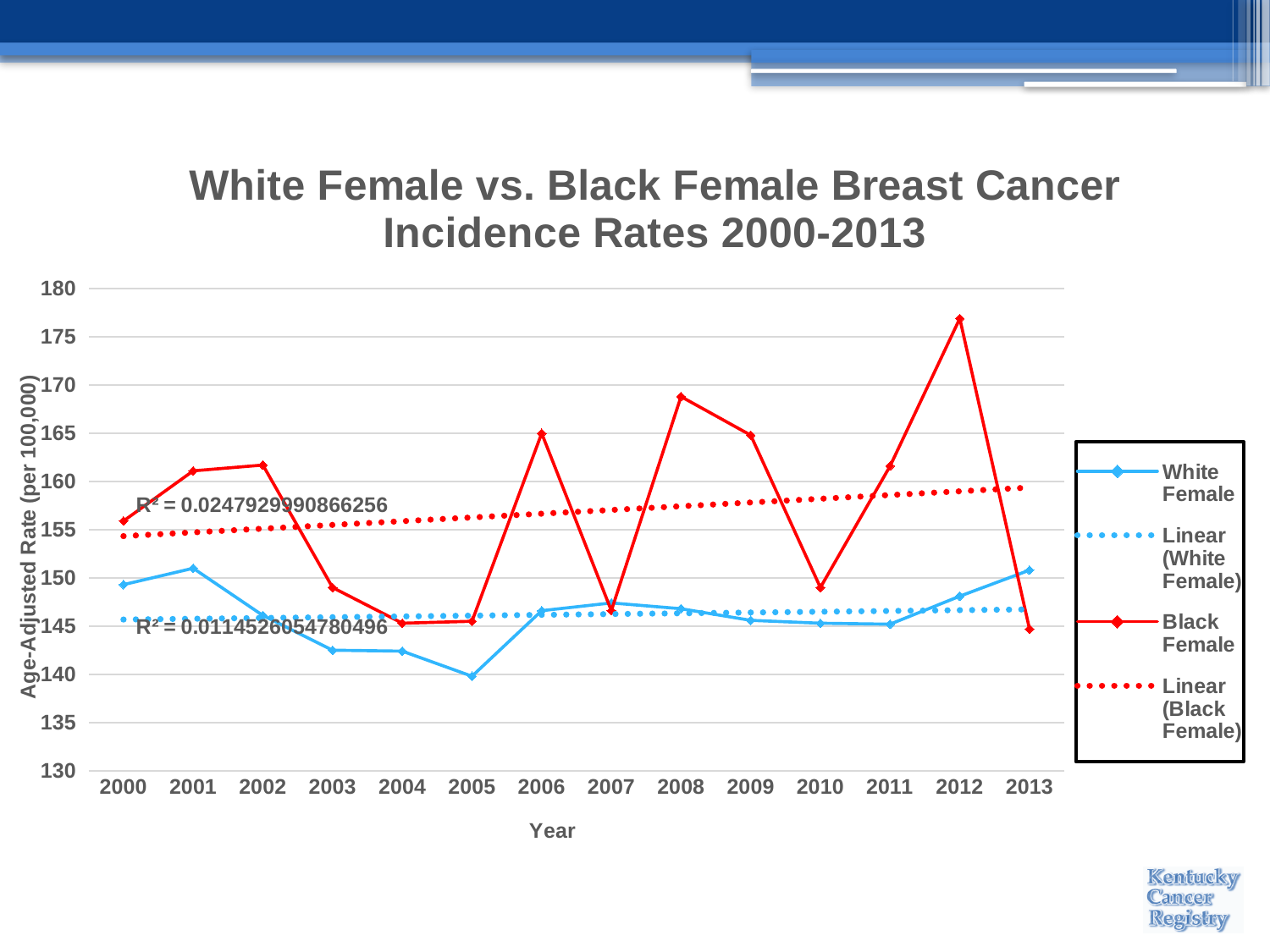
Is the Black Female value for 2012 greater or less than 175? greater Does the Linear (Black Female) trendline rise or fall from 2000 to 2013? rise What is the title of the chart? White Female vs. Black Female Breast Cancer Incidence Rates 2000-2013 Is the Black Female value for 2004 greater or less than 150? less Is the White Female value for 2005 greater or less than 145? less In which year is the White Female incidence rate lowest? 2005 For Black Female, which year has the larger value, 2006 or 2007? 2006 In 2008, which series has the larger value, White Female or Black Female? Black Female How many years are plotted along the x axis? 14 How many entries does the legend list? 4 What kind of chart is shown on the slide? line chart In which year is the Black Female incidence rate highest? 2012